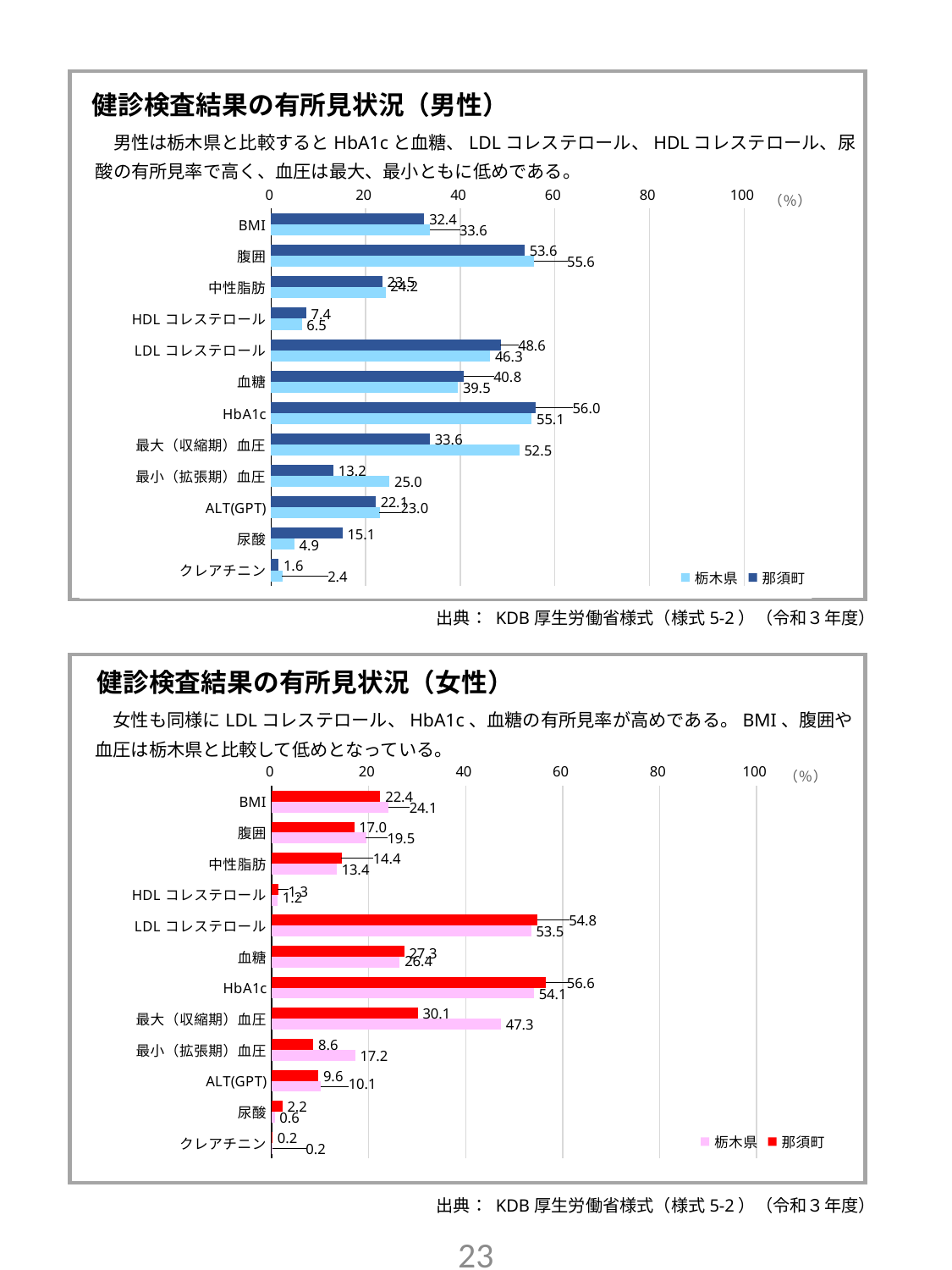
How many categories are shown in the bottom chart (女性)? 12 In the top chart (男性), which category has the lowest value for 栃木県? クレアチニン What type of chart is the bottom chart (女性)? Bar chart In the bottom chart (女性), which category has the highest value for 栃木県? HbA1c How many series does the legend of the top chart (男性) list? 2 In the bottom chart (女性), what is the difference between 栃木県 and 那須町 for 最小（拡張期）血圧? 8.6 In the top chart (男性), what is the value for 栃木県 for 最大（収縮期）血圧? 52.5 In the top chart (男性), what is the difference between 栃木県 and 那須町 for 最大（収縮期）血圧? 18.9 In the top chart (男性), which category has the highest value for 那須町? HbA1c In the top chart (男性), which is larger for 尿酸: 栃木県 or 那須町? 那須町 In the top chart (健診検査結果の有所見状況（男性）), what is the value for 那須町 for HbA1c? 56.0 In the bottom chart (健診検査結果の有所見状況（女性）), what is the value for 那須町 for LDL コレステロール? 54.8